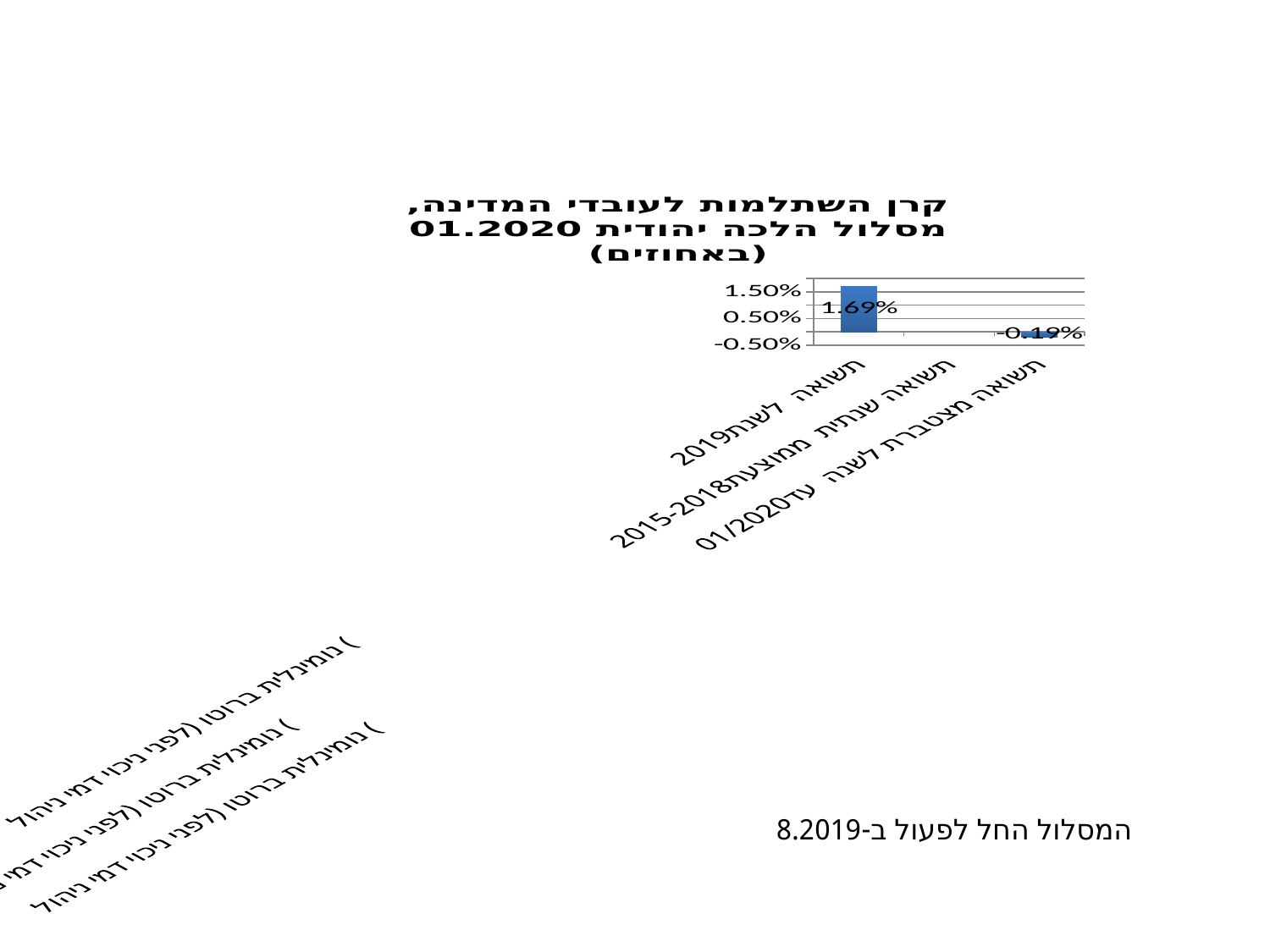
What is the difference between the value for תשואה לשנת 2019 and the value for תשואה מצטברת לשנה עד 01/2020? 1.88 percentage points What type of chart is shown on the slide? bar chart What is the value for תשואה לשנת 2019? 1.69% What is the title of the chart? קרן השתלמות לעובדי המדינה, מסלול הלכה יהודית 01.2020 (באחוזים) Which category has the lowest plotted value? תשואה מצטברת לשנה עד 01/2020 Which is larger: the value for תשואה לשנת 2019 or the value for תשואה מצטברת לשנה עד 01/2020? תשואה לשנת 2019 Which category on the chart has no bar plotted? תשואה שנתית ממוצעת 2015-2018 Is the value for תשואה מצטברת לשנה עד 01/2020 greater or less than 0.50%? less Is the value for תשואה לשנת 2019 greater or less than 1.50%? greater How many categories are shown on the x axis of the chart? 3 What is the value for תשואה מצטברת לשנה עד 01/2020? -0.19% Which category has the highest value? תשואה לשנת 2019